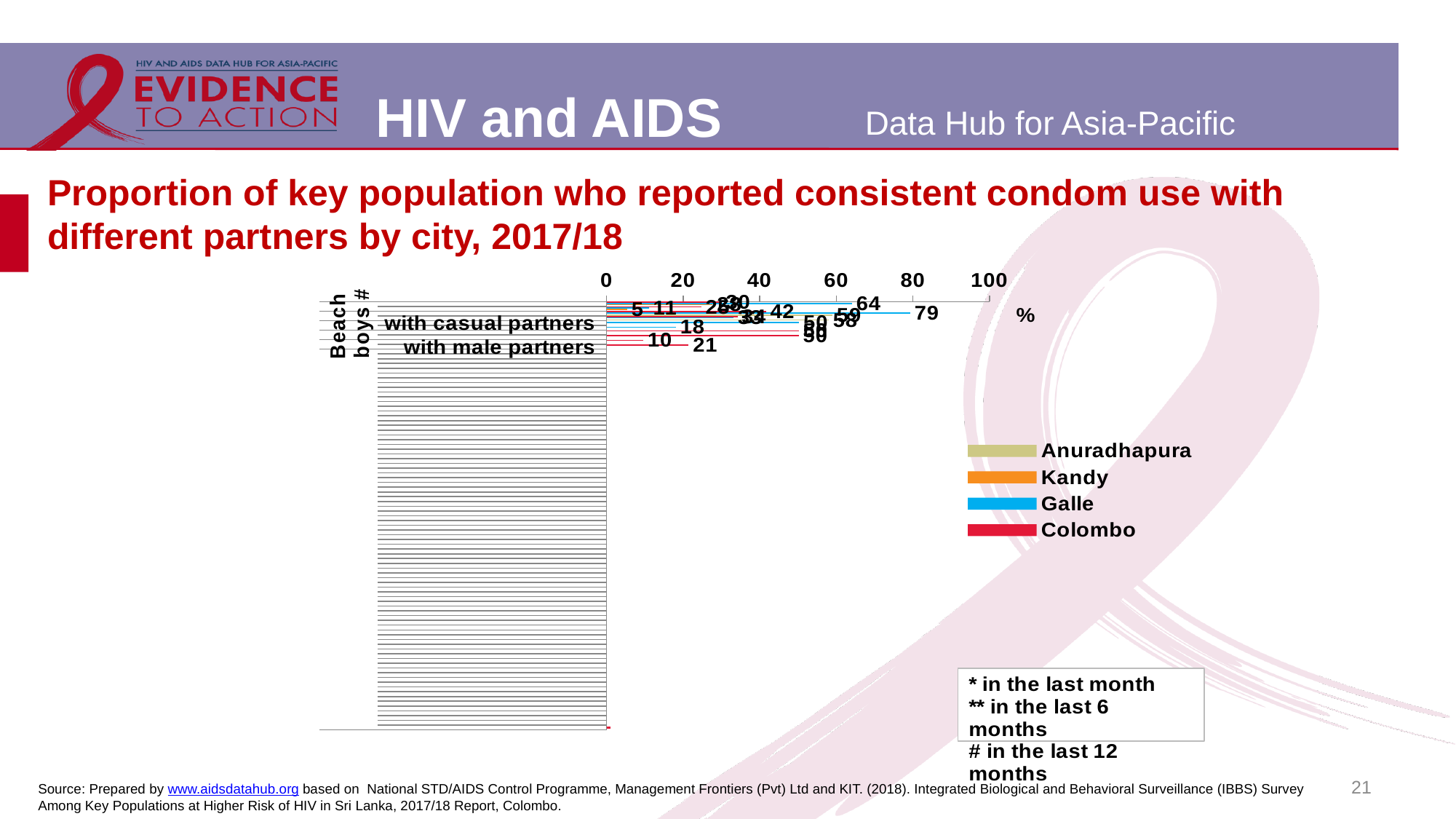
What kind of chart is shown on the slide? bar chart What is the highest value labelled on the chart? 79 How many cities does the chart legend list? 4 Which city is shown in red in the chart legend? Colombo Which city is listed first in the chart legend? Anuradhapura What is the lowest value labelled on the chart? 5